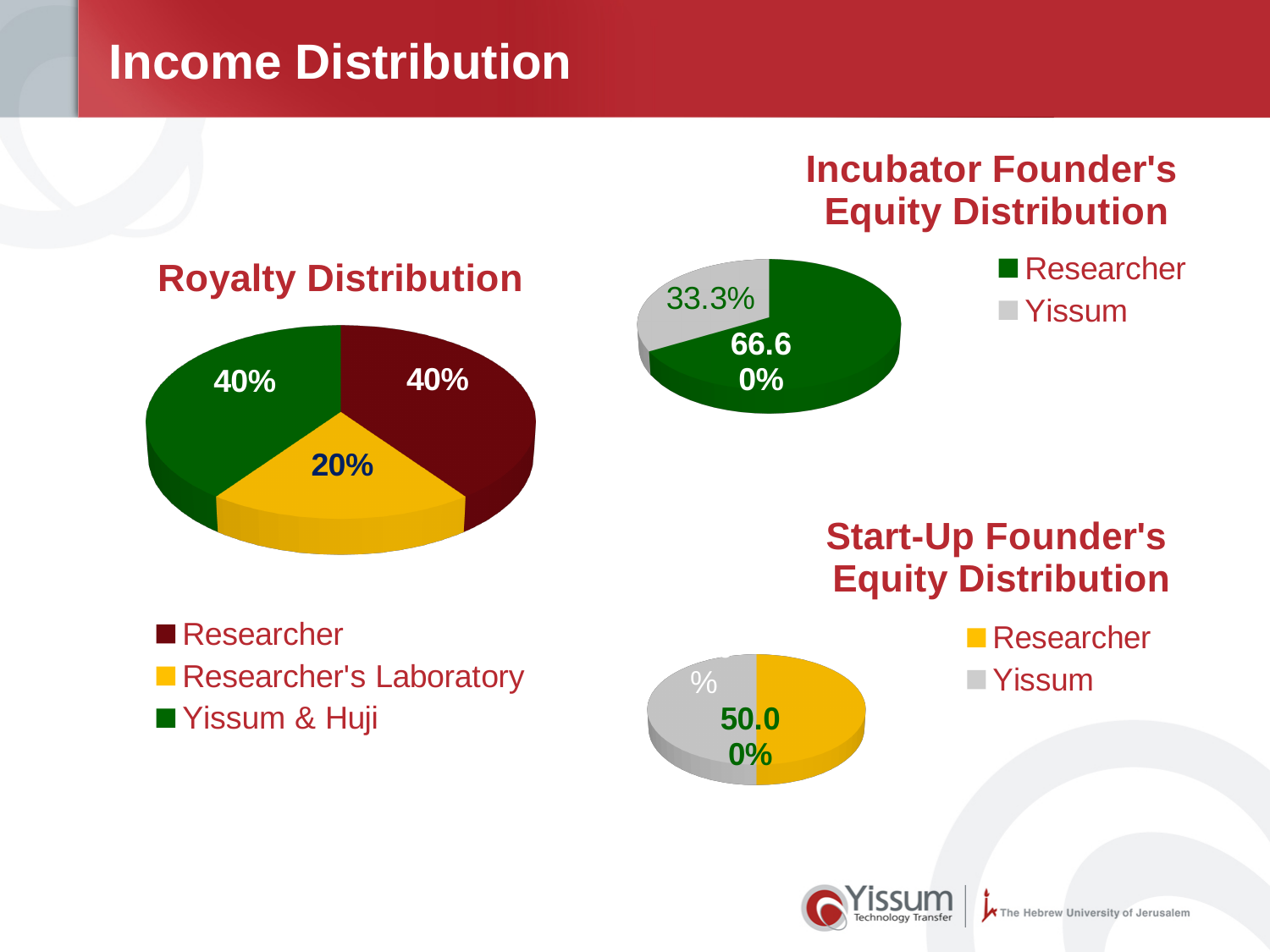
In the Incubator Founder's Equity Distribution chart, which category has the larger share, Researcher or Yissum? Researcher What kind of chart is the Royalty Distribution chart? Pie chart In the Incubator Founder's Equity Distribution chart, what share goes to the Researcher? 66.60% In the Incubator Founder's Equity Distribution chart, what share goes to Yissum? 33.3% In the Start-Up Founder's Equity Distribution chart, how many categories does the legend list? 2 In the Royalty Distribution chart, how many categories does the legend list? 3 In the Start-Up Founder's Equity Distribution chart, what share goes to the Researcher? 50.00% In the Incubator Founder's Equity Distribution chart, what colour represents Yissum? Grey In the Royalty Distribution chart, what is the difference between the Researcher share and the Researcher's Laboratory share? 20% In the Royalty Distribution chart, which category has the smallest share? Researcher's Laboratory In the Royalty Distribution chart, what share goes to the Researcher's Laboratory? 20% In the Royalty Distribution chart, what share goes to Yissum & Huji? 40%